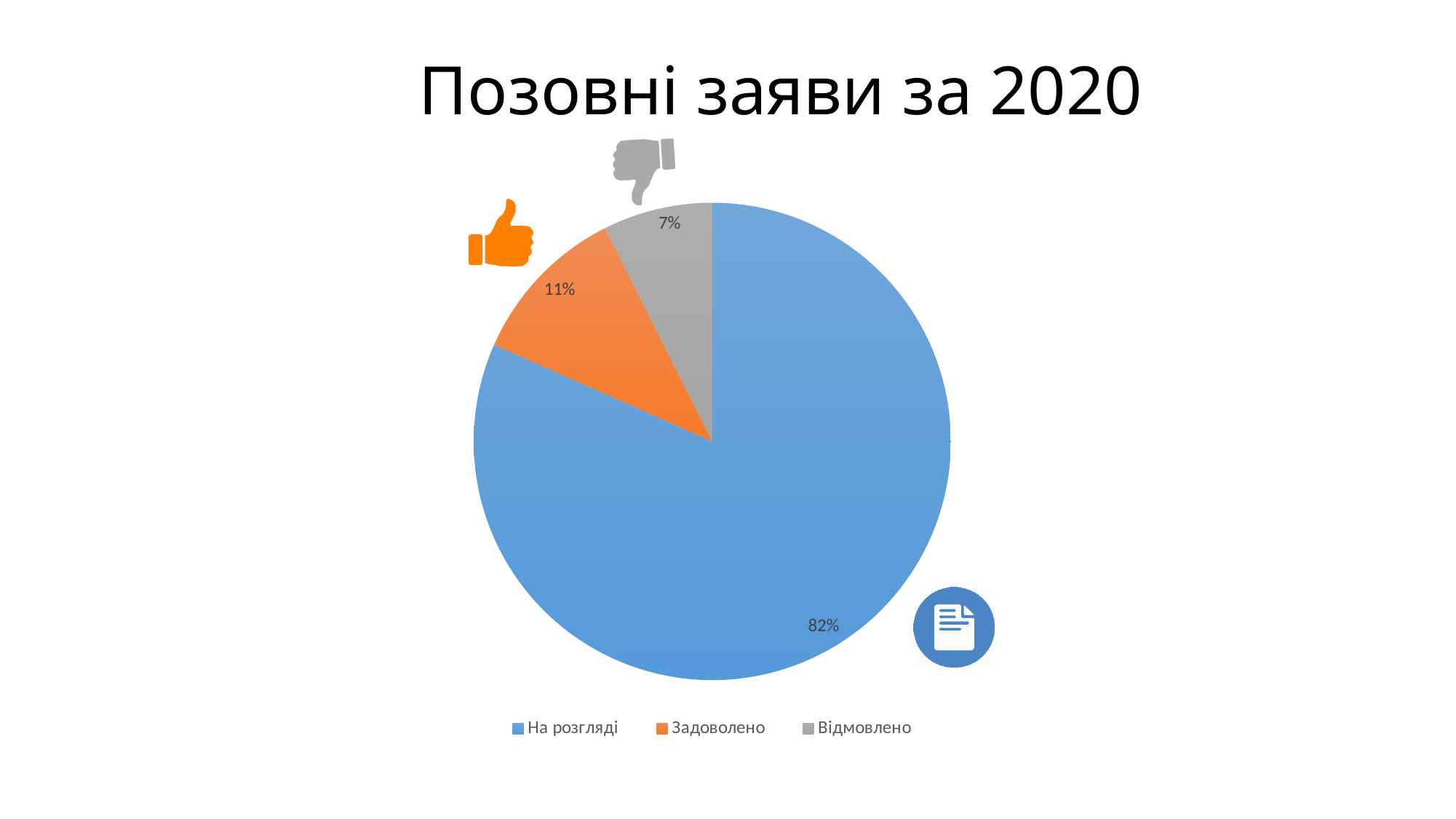
Which category has the largest slice of the pie? На розгляді What is the difference in percentage points between Задоволено and Відмовлено? 4 What is the difference in percentage points between На розгляді and Задоволено? 71 What colour is the slice for Задоволено? orange What share of the pie is labelled for Відмовлено? 7% Which is larger, the slice for Задоволено or the slice for Відмовлено? Задоволено What kind of chart is shown on the slide? pie chart What share of the pie is labelled for Задоволено? 11% Which category has the smallest slice of the pie? Відмовлено How many categories does the pie chart have? 3 What share of the pie is labelled for На розгляді? 82% What is the title of the chart? Позовні заяви за 2020